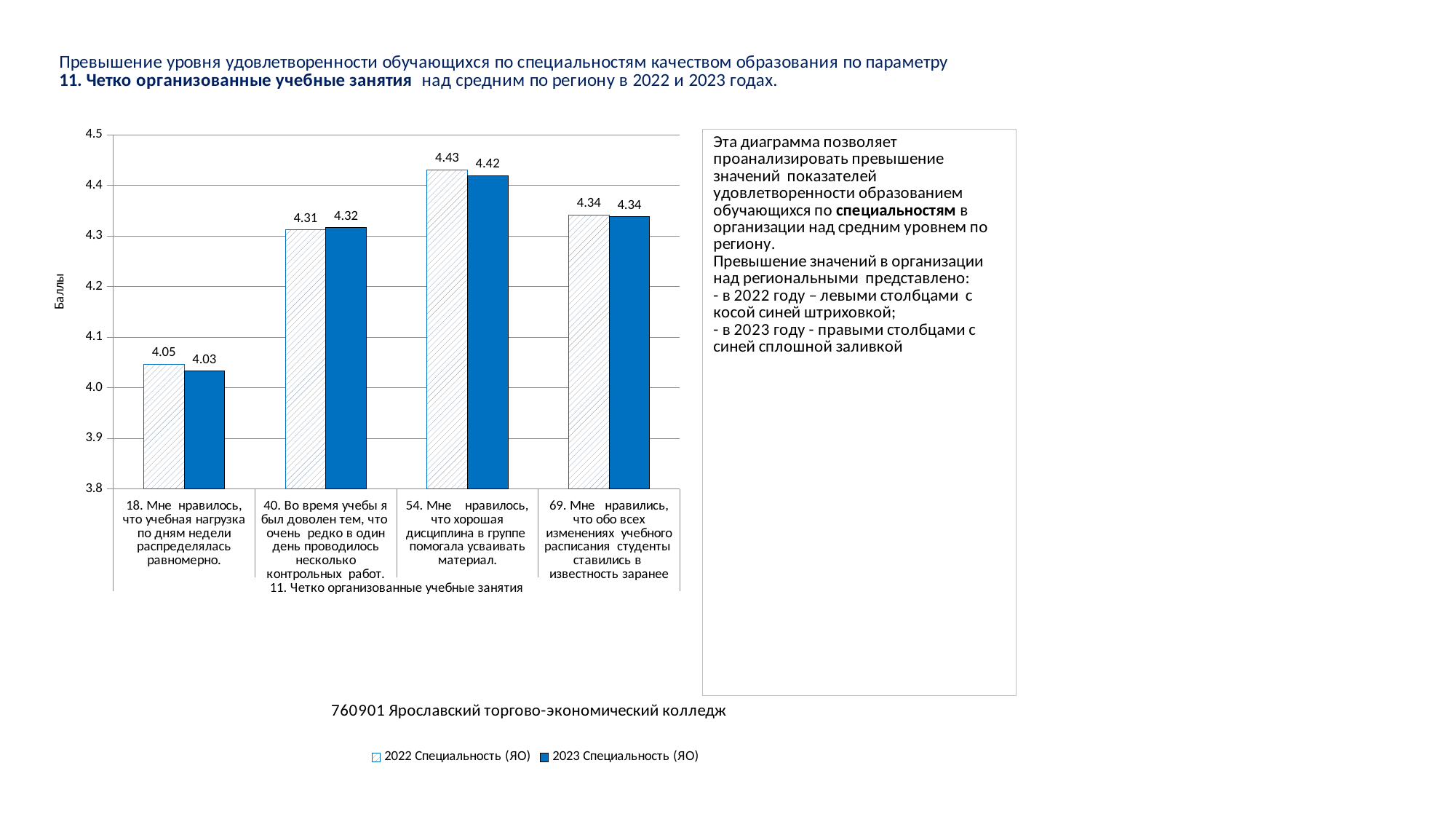
What is the value for "2023 Специальность (ЯО)" for category 40 (Во время учебы я был доволен тем, что очень редко в один день проводилось несколько контрольных работ)? 4.32 For category 40, which series has the larger value: 2022 or 2023? 2023 Специальность (ЯО) Is the 2022 value for category 69 greater or less than 4.3? greater What is the value for "2022 Специальность (ЯО)" for category 18 (Мне нравилось, что учебная нагрузка по дням недели распределялась равномерно)? 4.05 How many series does the legend list? 2 What is the value for "2023 Специальность (ЯО)" for category 54 (Мне нравилось, что хорошая дисциплина в группе помогала усваивать материал)? 4.42 What type of chart is shown on the slide? bar chart Which category has the highest value for "2022 Специальность (ЯО)"? 54. Мне нравилось, что хорошая дисциплина в группе помогала усваивать материал. What is the difference between the 2022 and 2023 values for category 18? 0.02 How many categories are shown on the x axis? 4 Which category has the lowest value for "2023 Специальность (ЯО)"? 18. Мне нравилось, что учебная нагрузка по дням недели распределялась равномерно. What is the difference between the 2022 values for category 54 and category 18? 0.38